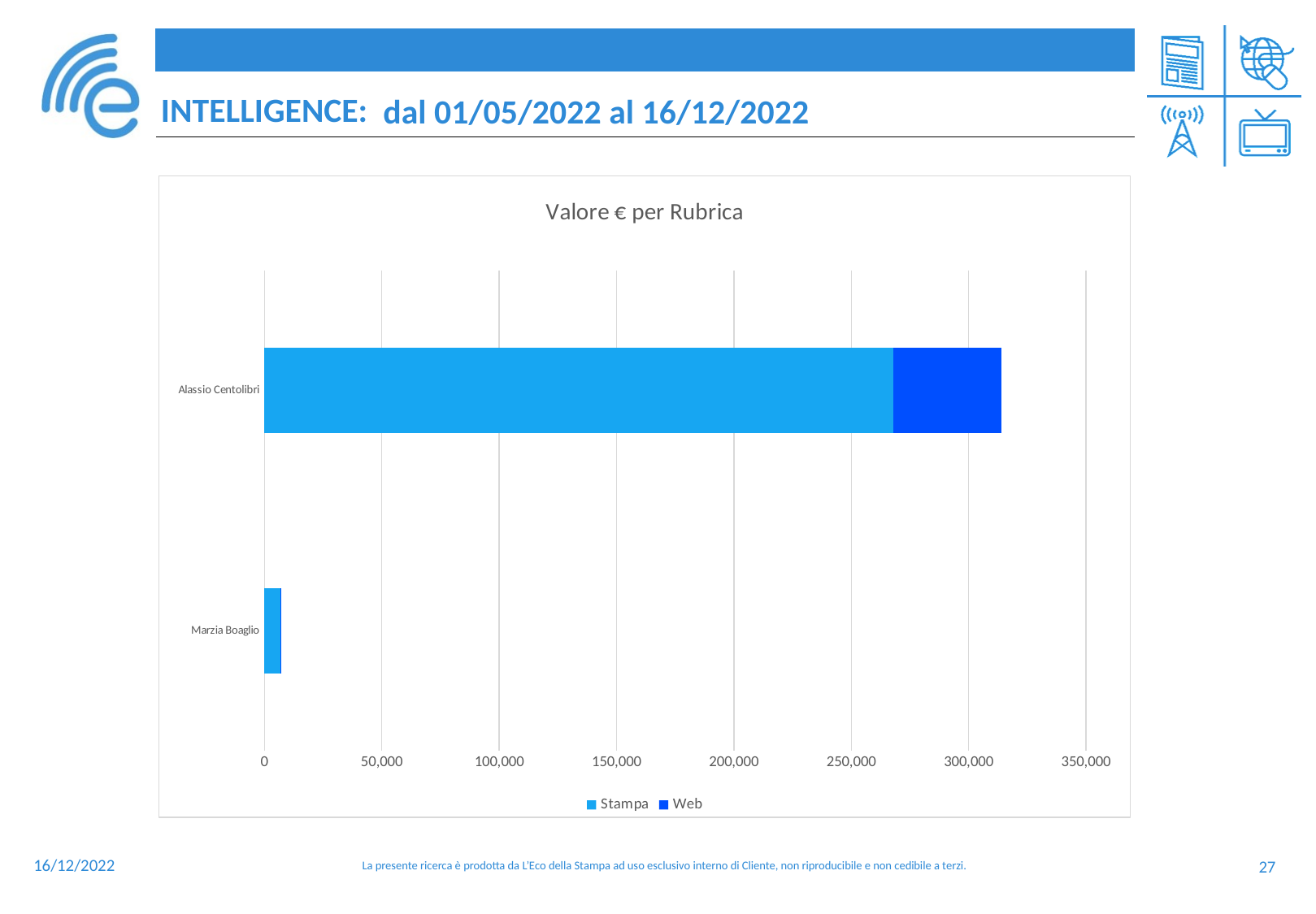
How many categories are shown on the chart? 2 For Alassio Centolibri, which series is larger, Stampa or Web? Stampa What kind of chart is shown on the slide? bar chart How many series does the legend list? 2 Which category has the highest total value? Alassio Centolibri What is the title of the chart? Valore € per Rubrica Which series are listed in the legend? Stampa, Web Is the total value for Alassio Centolibri greater or less than 300,000? greater Is the value for Marzia Boaglio greater or less than 50,000? less Which is larger, the total value for Alassio Centolibri or for Marzia Boaglio? Alassio Centolibri Which category has the lowest total value? Marzia Boaglio Is the Stampa value for Alassio Centolibri greater or less than 250,000? greater